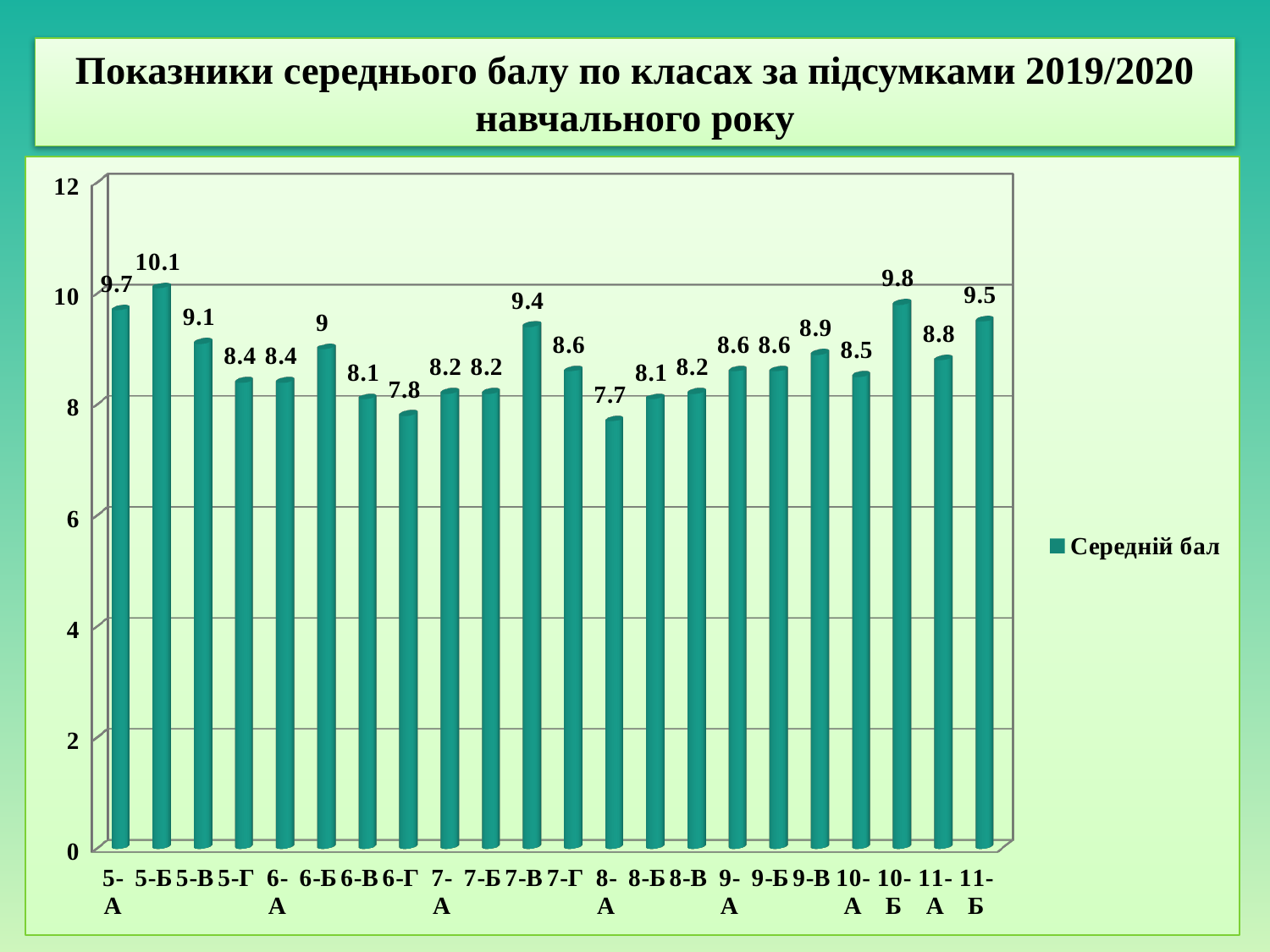
How many classes are shown on the chart? 22 What is the average score for class 10-Б? 9.8 What type of chart is shown on the slide? bar chart What is the average score for class 5-Б? 10.1 How many series does the legend list? 1 Which class has the lowest average score? 8-А Is the value for 6-Г greater or less than 8? less What is the average score for class 8-А? 7.7 Which class has a higher average score, 7-В or 11-Б? 11-Б Which class has the highest average score? 5-Б What is the average score for class 6-Б? 9 What is the difference between the average scores of 5-Б and 8-А? 2.4